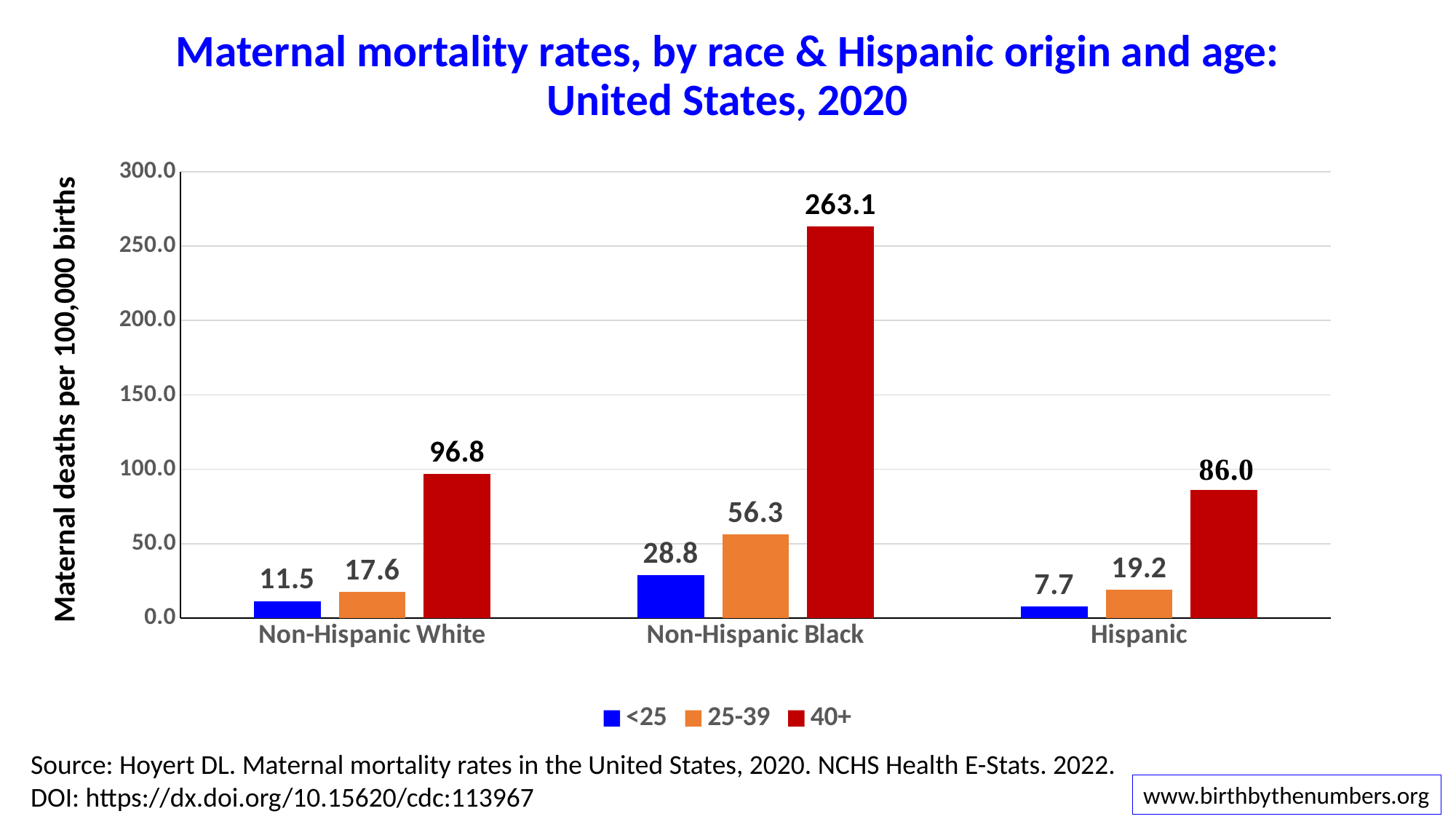
Which race/Hispanic origin group has the lowest maternal mortality rate in the <25 age group? Hispanic What kind of chart is shown on the slide? Bar chart What is the difference between the 40+ maternal mortality rates for Non-Hispanic Black and Non-Hispanic White women? 166.3 Is the maternal mortality rate for Non-Hispanic White women aged 40+ greater or less than 100.0? less What is the maternal mortality rate for Non-Hispanic Black women aged 40+? 263.1 Which colour represents the 40+ age group in the chart? Red How many race/Hispanic origin groups are shown on the x axis? 3 What is the maternal mortality rate for Hispanic women under 25? 7.7 What is the maternal mortality rate for Non-Hispanic White women aged 25-39? 17.6 Which is larger: the 25-39 rate for Non-Hispanic Black women or the 40+ rate for Hispanic women? 40+ rate for Hispanic women How many age groups does the legend list? 3 Which race/Hispanic origin group has the highest maternal mortality rate in the 40+ age group? Non-Hispanic Black